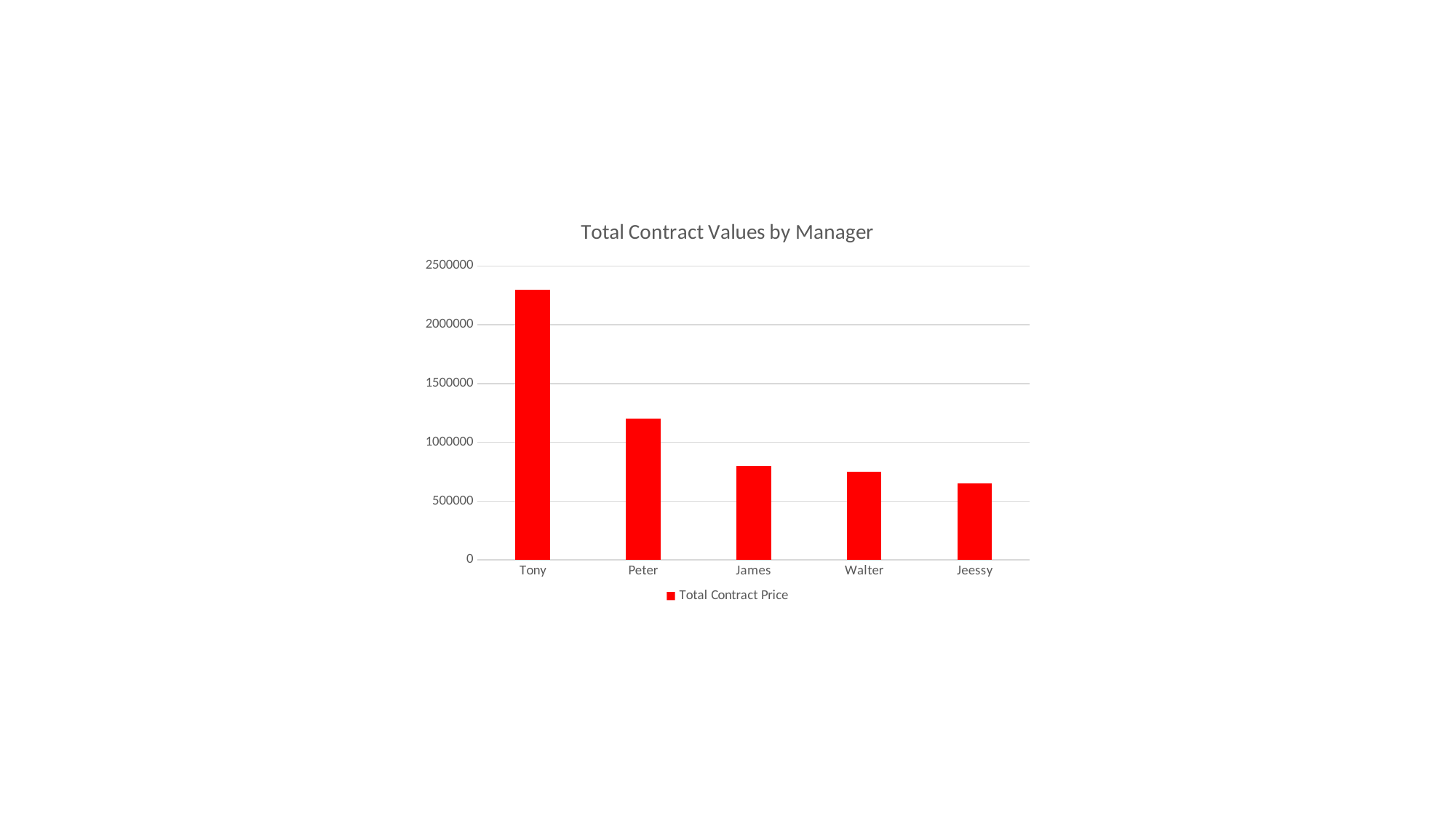
Do the values rise or fall moving from Tony to Jeessy along the x axis? Fall Is the value for Jeessy greater or less than 1000000? less How many managers are shown on the x axis of the chart? 5 Is the value for Tony greater or less than 2000000? greater Which is larger, the value for Peter or the value for James? Peter Which manager has the highest total contract value? Tony What is the title of the chart? Total Contract Values by Manager How many series does the legend list? 1 What is the name of the series shown in the legend? Total Contract Price Which manager has the lowest total contract value? Jeessy What type of chart is shown on the slide? Bar chart Is the value for Peter greater or less than 1000000? greater